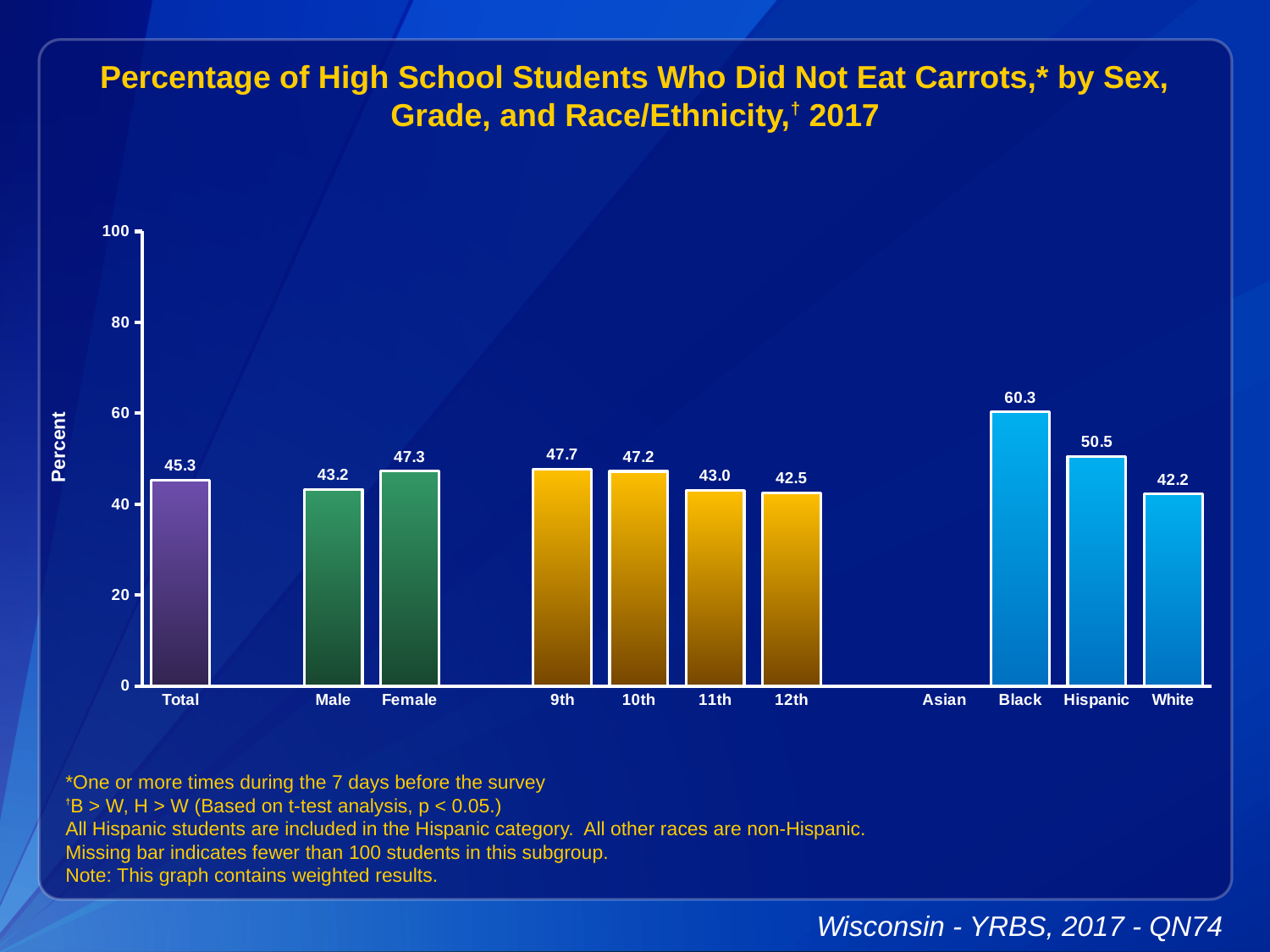
What is the difference between the Female and Male values? 4.1 Is the value for Black greater or less than 60? greater What is the value for 12th grade? 42.5 Which category has the highest value? Black What is the value for Female? 47.3 Which category has no bar shown? Asian What is the difference between the Black and White values? 18.1 Which category with a bar has the lowest value? White What kind of chart is this? bar chart Which is larger, the value for 9th grade or 11th grade? 9th What is the value for Hispanic? 50.5 What is the value for Total? 45.3